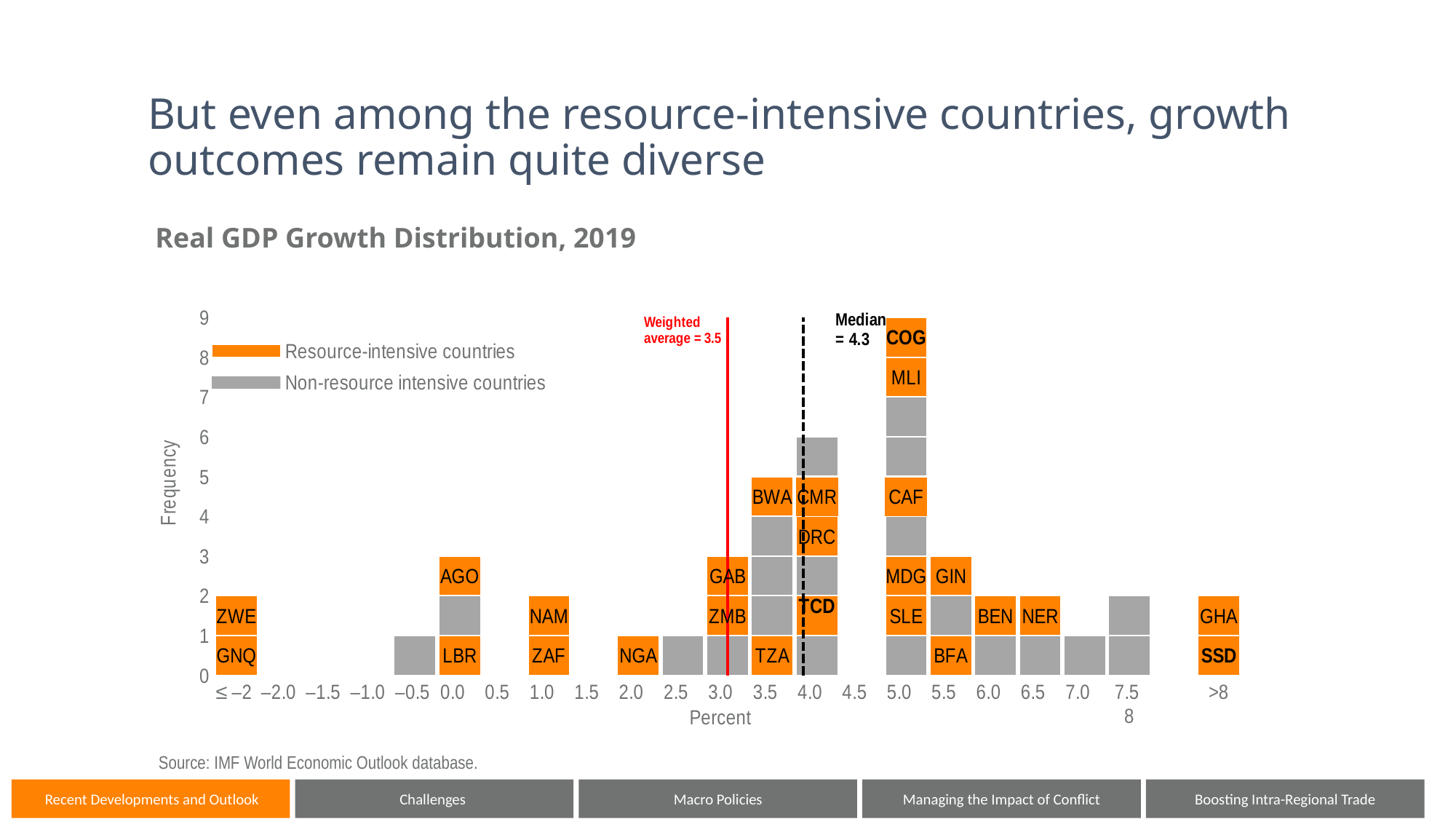
In which growth bin does COG appear? 5.0 Which growth bin on the x axis has the highest frequency? 5.0 What is the title of the chart? Real GDP Growth Distribution, 2019 What is the frequency for the 5.0 percent bin? 9 What is the frequency for the 3.5 percent bin? 5 What is the median value marked by the dashed line? 4.3 What is the weighted average marked by the red line? 3.5 Which bin has the higher frequency, 3.5 or 4.0? 4.0 How many series does the legend list? 2 What kind of chart is shown on the slide? Bar chart What is the frequency for the 4.0 percent bin? 6 What is the difference in frequency between the 5.0 bin and the 4.0 bin? 3